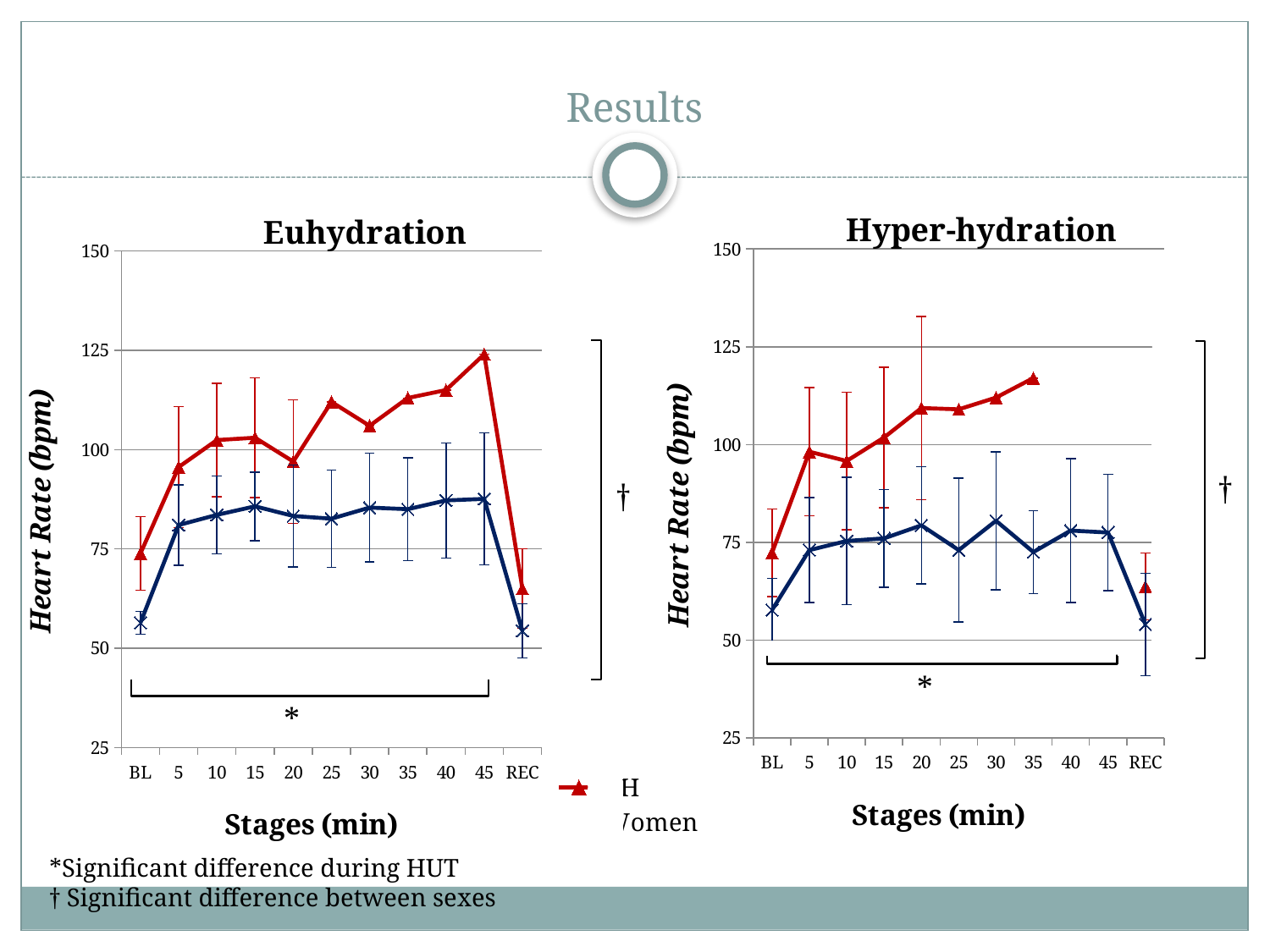
In the Euhydration chart, is the value of the blue x series at BL greater or less than 75? less In the Euhydration chart, at which stage is the red triangle series lowest? REC How many stages are shown on the x axis of the Hyper-hydration chart? 11 In the Hyper-hydration chart, is the value of the blue x series at BL greater or less than 75? less In the Euhydration chart, which series has the larger value at stage 45, the red triangle series or the blue x series? the red triangle series In the Euhydration chart, at which stage does the red triangle series reach its highest value? 45 In the Hyper-hydration chart, at which stage does the red triangle series reach its highest value? 35 What type of chart is the Euhydration chart? line chart In the Euhydration chart, does the red triangle series rise or fall from stage 45 to REC? fall What is the y-axis title of the Hyper-hydration chart? Heart Rate (bpm) In the Euhydration chart, is the value of the red triangle series at stage 45 greater or less than 100? greater